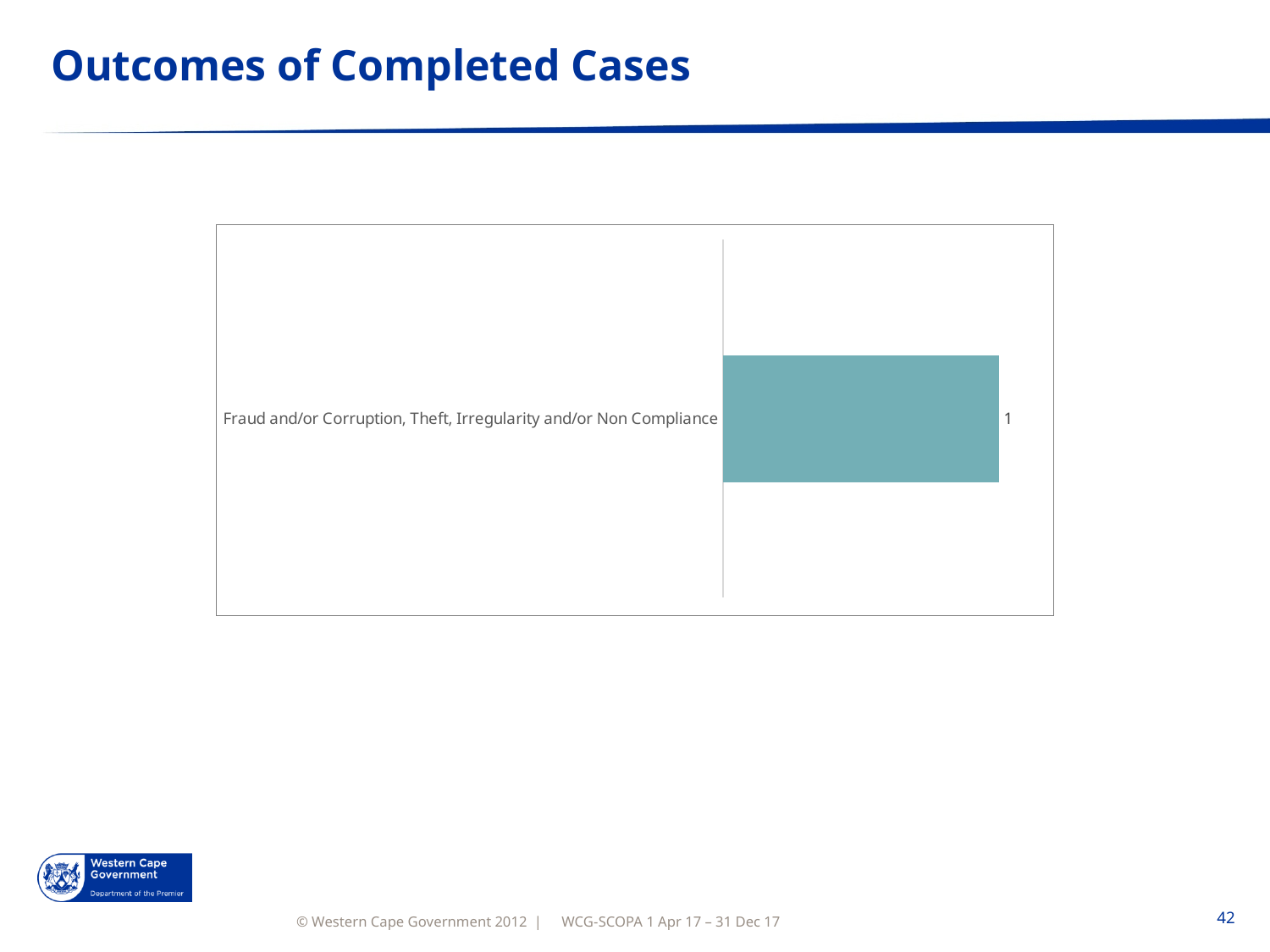
Are the bars in the chart horizontal or vertical? horizontal How many categories does the chart show? 1 What kind of chart is shown on the slide? bar chart What is the value for Fraud and/or Corruption, Theft, Irregularity and/or Non Compliance? 1 What is the title of the slide containing the chart? Outcomes of Completed Cases What is the label of the only category in the chart? Fraud and/or Corruption, Theft, Irregularity and/or Non Compliance